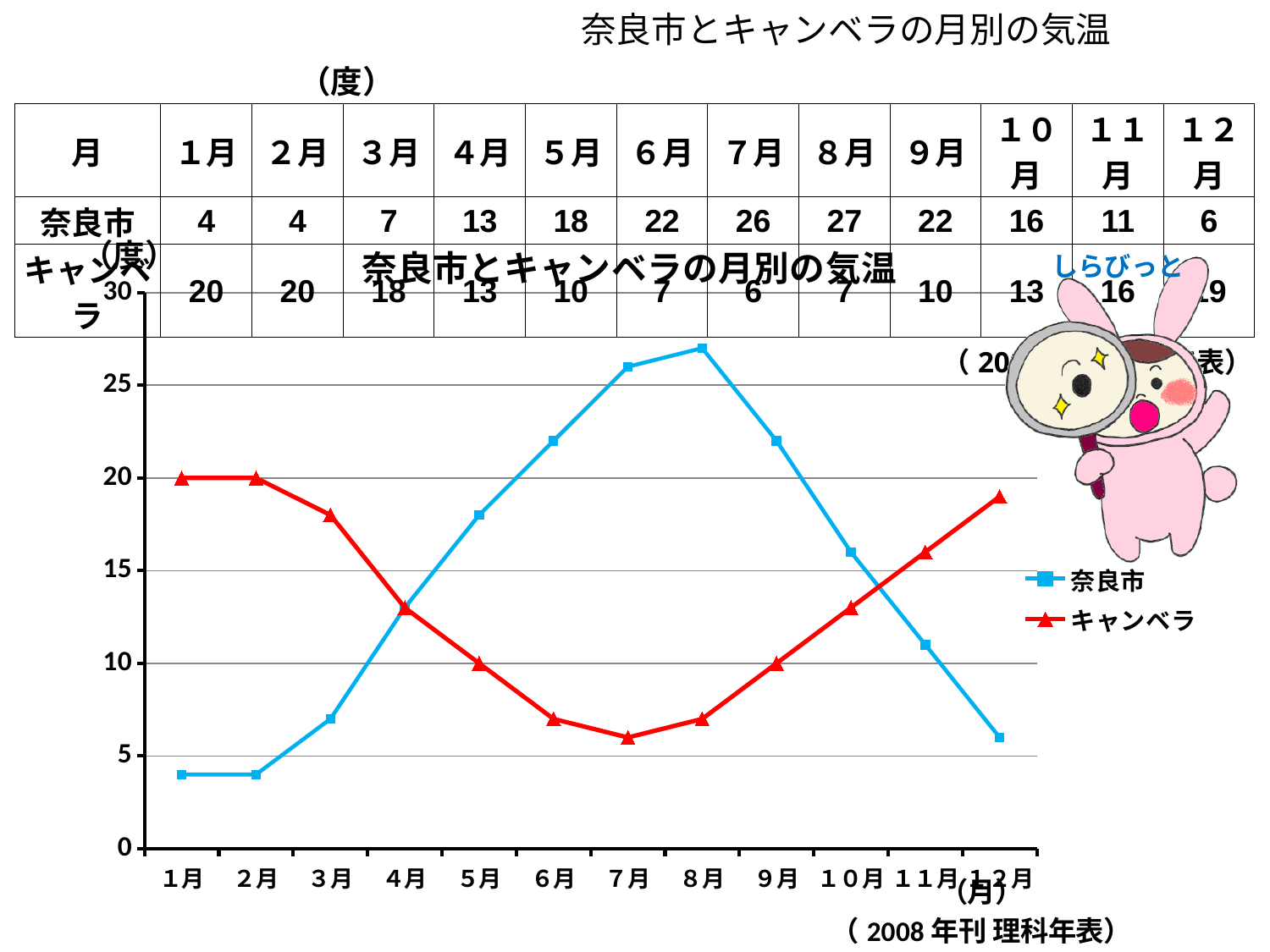
What is the title of the chart? 奈良市とキャンベラの月別の気温 Does the 奈良市 line rise or fall from 1月 to 8月? rise In 3月, which is higher, the temperature for 奈良市 or for キャンベラ? キャンベラ Is the temperature for 奈良市 in 6月 greater or less than 20? greater In which month is the temperature for キャンベラ lowest? 7月 What is the temperature for キャンベラ in 1月? 20 What is the difference between the 奈良市 and キャンベラ temperatures in 8月? 20 What is the temperature for 奈良市 in 7月? 26 In which month is the temperature for 奈良市 highest? 8月 How many series does the chart legend list? 2 How many months are plotted along the x axis of the chart? 12 What kind of chart is shown on the slide? line chart